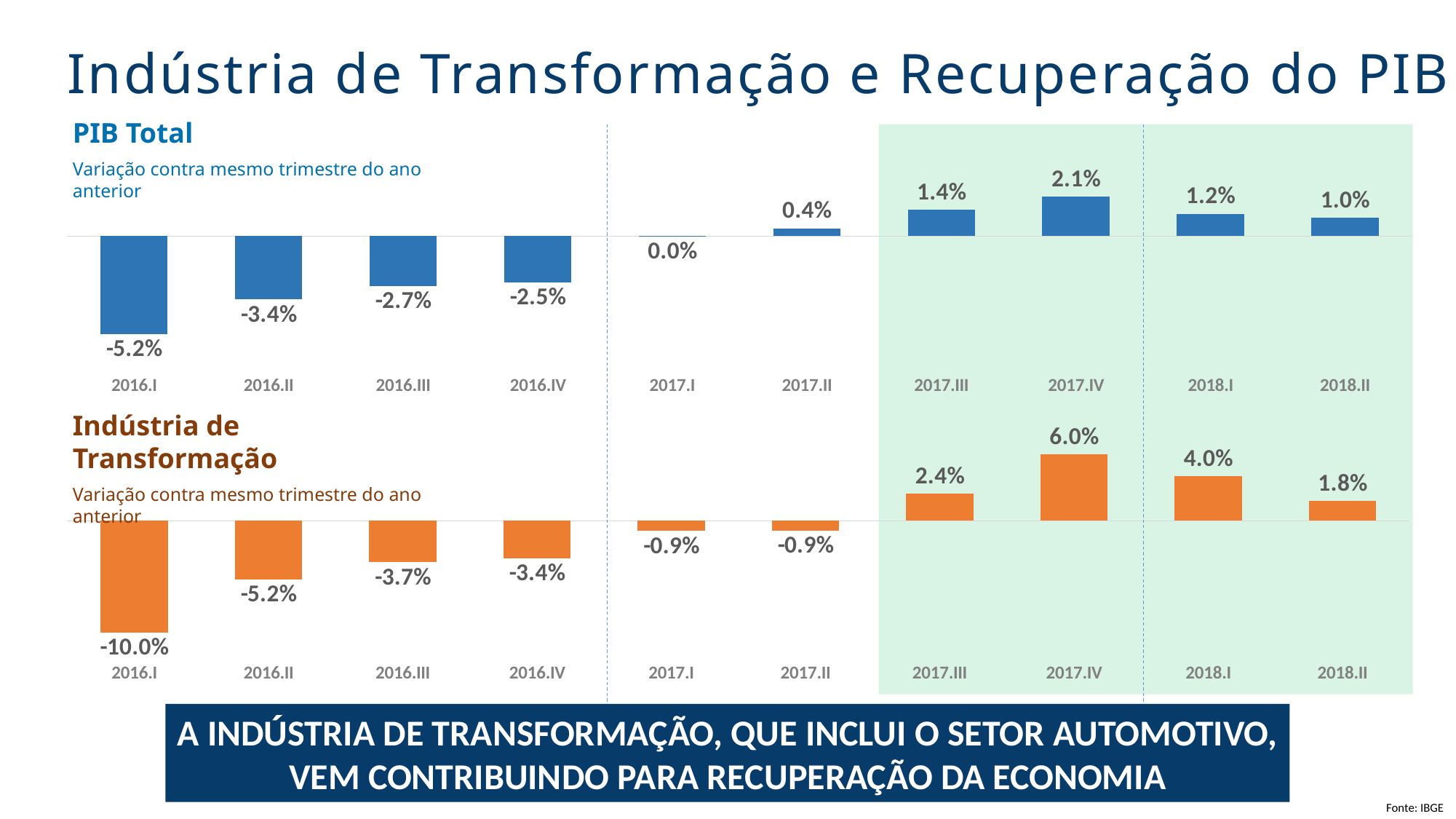
What type of chart is the Indústria de Transformação chart? Bar chart In the Indústria de Transformação chart, what is the value for 2018.I? 4.0% In the Indústria de Transformação chart, what is the value for 2016.I? -10.0% In the PIB Total chart, what is the difference between the values for 2016.I and 2016.II? 1.8 percentage points In the Indústria de Transformação chart, what is the difference between the values for 2017.IV and 2018.II? 4.2 percentage points In the PIB Total chart, what is the value for 2017.IV? 2.1% In the Indústria de Transformação chart, which quarter has the lowest value? 2016.I In the PIB Total chart, which quarter has the highest value? 2017.IV What colour are the bars in the Indústria de Transformação chart? Orange In the PIB Total chart, do the values rise or fall from 2016.I to 2017.IV? Rise How many quarters are shown on the x axis of the PIB Total chart? 10 Which is larger: the 2018.I value in the PIB Total chart or the 2018.I value in the Indústria de Transformação chart? Indústria de Transformação